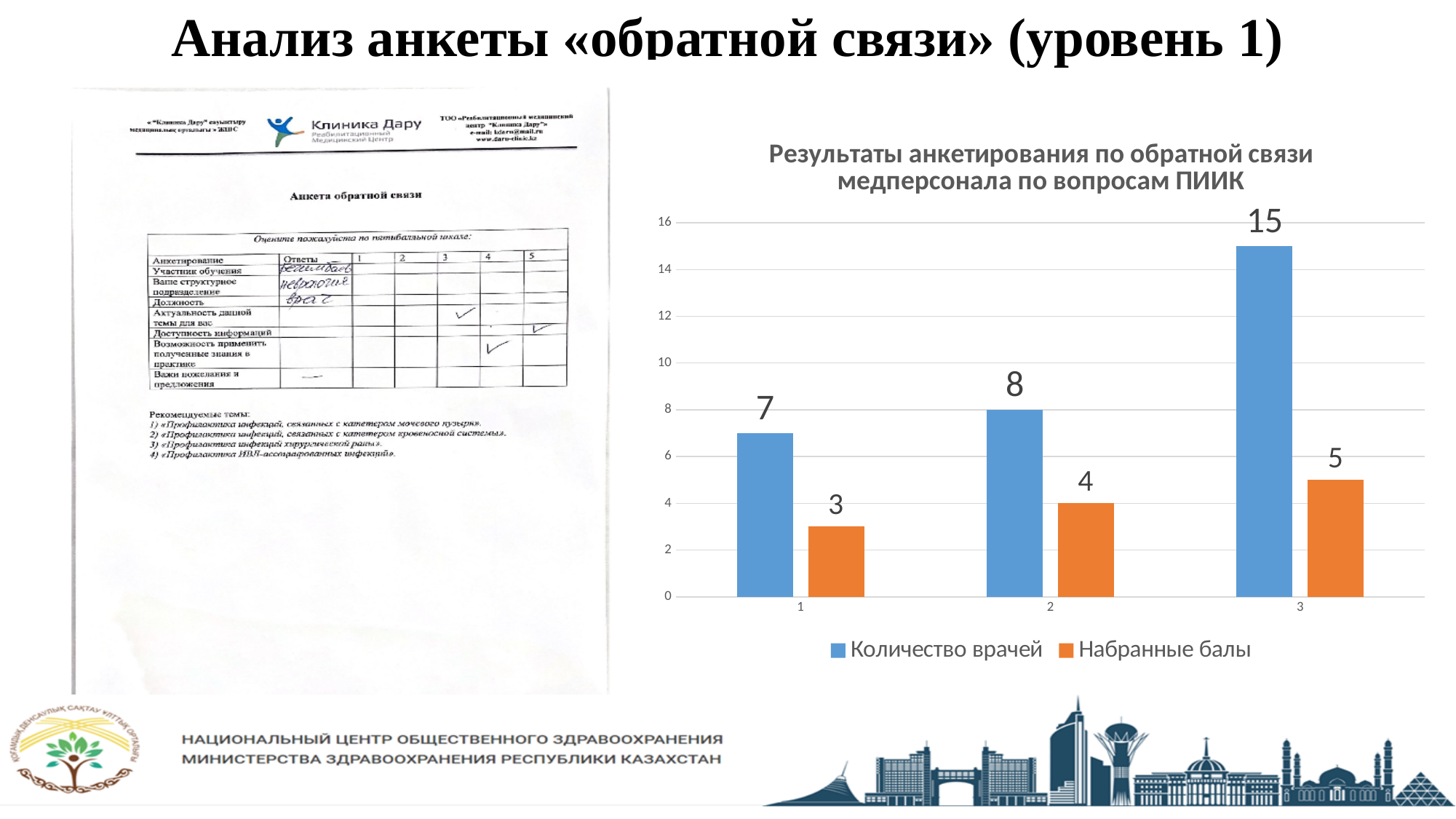
Do the values of "Набранные балы" rise or fall from category 1 to category 3? Rise Which is larger for category 2: "Количество врачей" or "Набранные балы"? Количество врачей What is the value of "Набранные балы" for category 1? 3 What is the value of "Количество врачей" for category 2? 8 What is the value of "Количество врачей" for category 3? 15 What type of chart is shown on the slide? Bar chart Which category has the lowest value for "Набранные балы"? 1 How many series does the chart legend list? 2 What is the difference between "Количество врачей" and "Набранные балы" for category 3? 10 Which category has the highest value for "Количество врачей"? 3 How many categories are shown on the x axis of the chart? 3 What is the title of the chart? Результаты анкетирования по обратной связи медперсонала по вопросам ПИИК